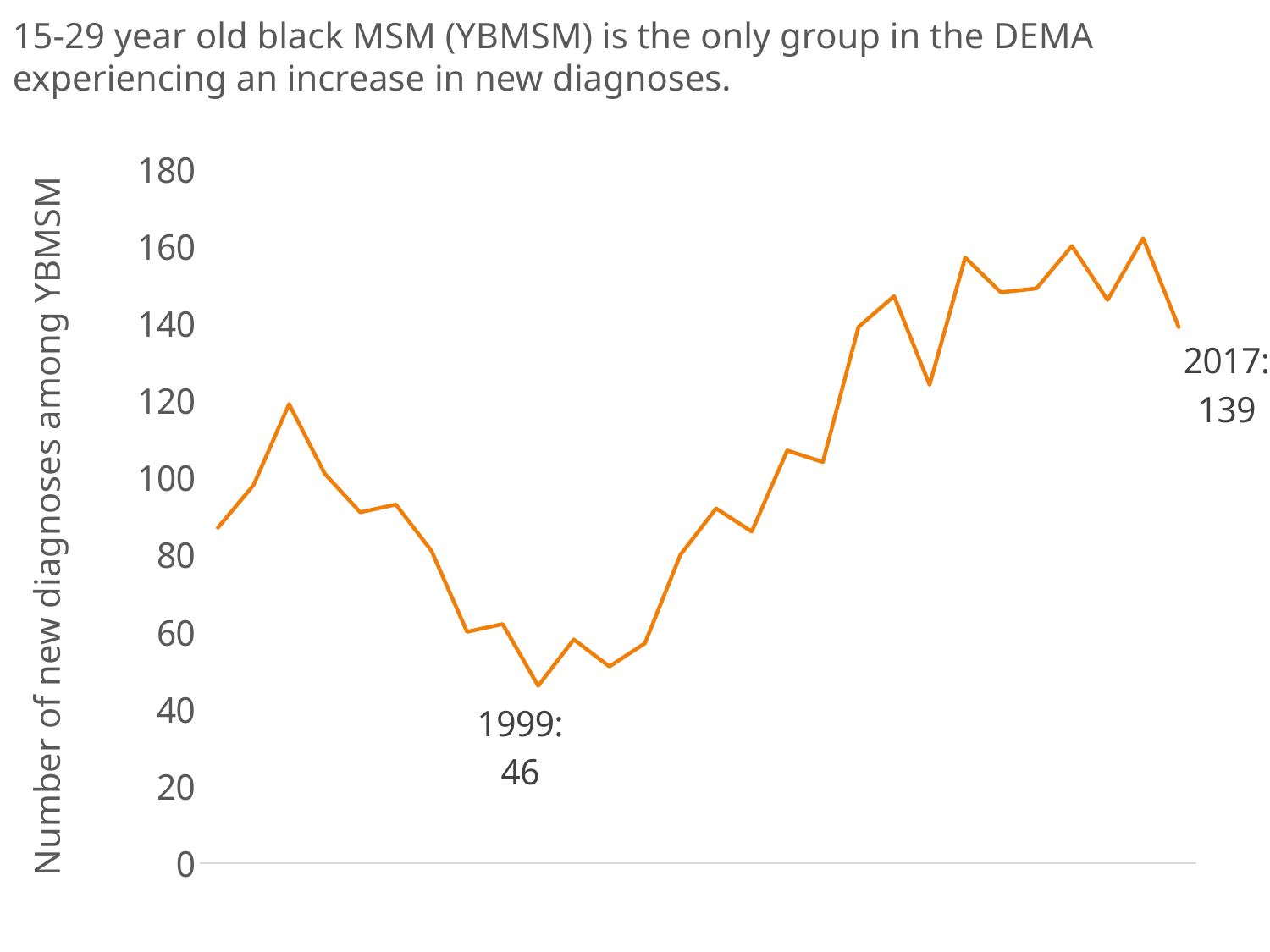
What is the number of new diagnoses among YBMSM in 2017? 139 What is the label of the vertical axis? Number of new diagnoses among YBMSM What is the number of new diagnoses among YBMSM in 1999? 46 What colour is the line in the chart? orange What kind of chart is shown on the slide? line chart Is the value for 1999 greater or less than 60? less Which year has the higher number of new diagnoses, 1999 or 2017? 2017 Of the two labeled years, which has the lower number of new diagnoses? 1999 Is the highest point on the line greater or less than 140? greater By how much did the number of new diagnoses among YBMSM increase from 1999 to 2017? 93 Does the number of new diagnoses among YBMSM rise or fall between 1999 and 2017? rise Is the first point on the line greater or less than 100? less